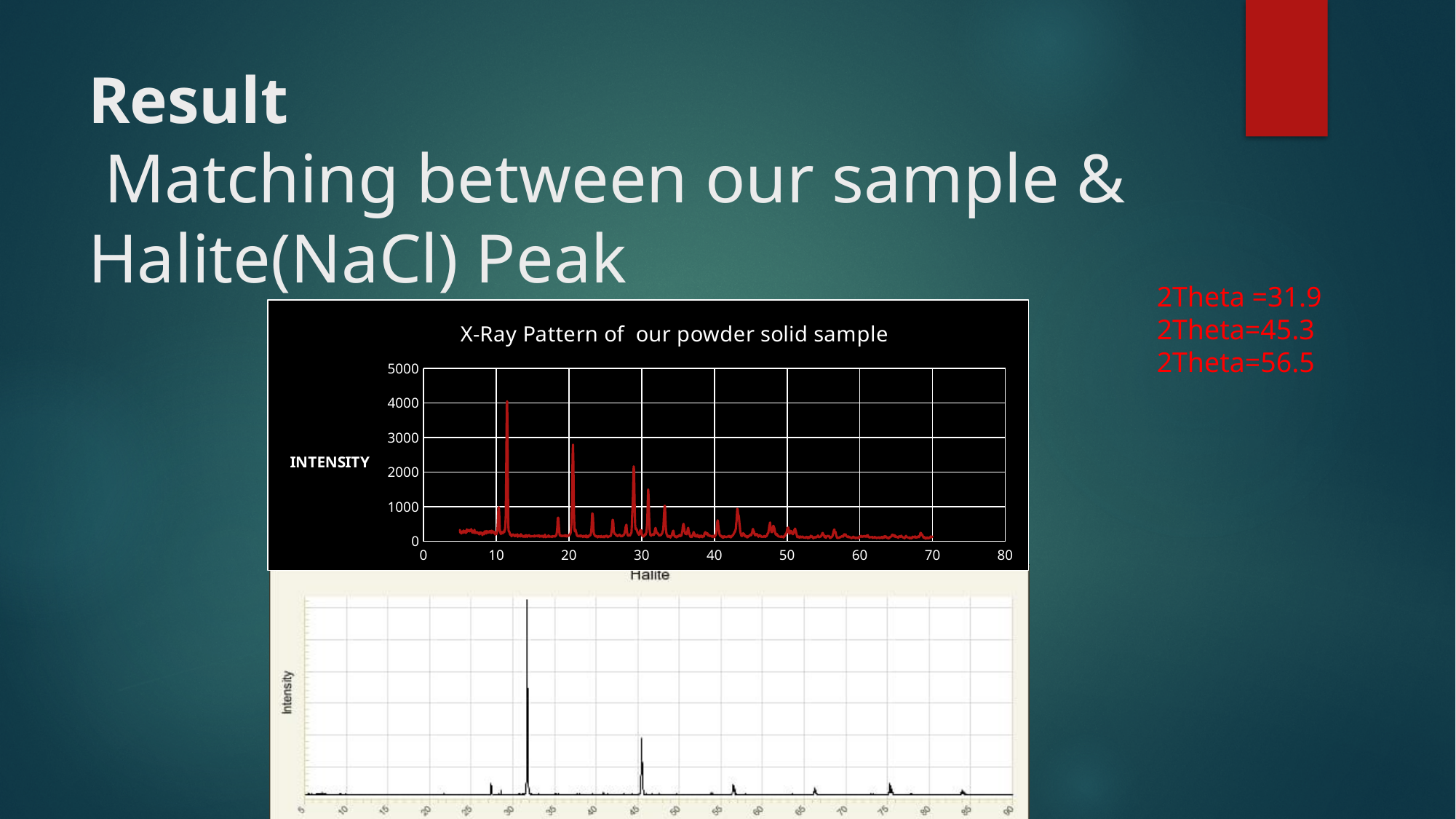
What kind of chart is the top chart titled 'X-Ray Pattern of our powder solid sample'? line chart In the top chart, is the intensity of the peak near 2θ = 20 greater or less than 3000? less In the bottom 'Halite' chart, which peak is taller: the one near 2θ = 31 or the one near 2θ = 45? the one near 2θ = 31 In the bottom 'Halite' chart, which peak is taller: the one near 2θ = 45 or the one near 2θ = 56? the one near 2θ = 45 What is the title of the bottom chart on the slide? Halite What is the title of the top chart on the slide? X-Ray Pattern of our powder solid sample In the top chart, is the intensity of the tallest peak greater or less than 3000? greater In the top chart, what colour is the plotted line? red In the top chart, is the intensity of the peak near 2θ = 29 greater or less than 1000? greater In the top chart, do the peak intensities generally rise or fall as 2θ increases from 10 to 70? fall In the top chart, which peak is taller: the one near 2θ = 11 or the one near 2θ = 20? the one near 2θ = 11